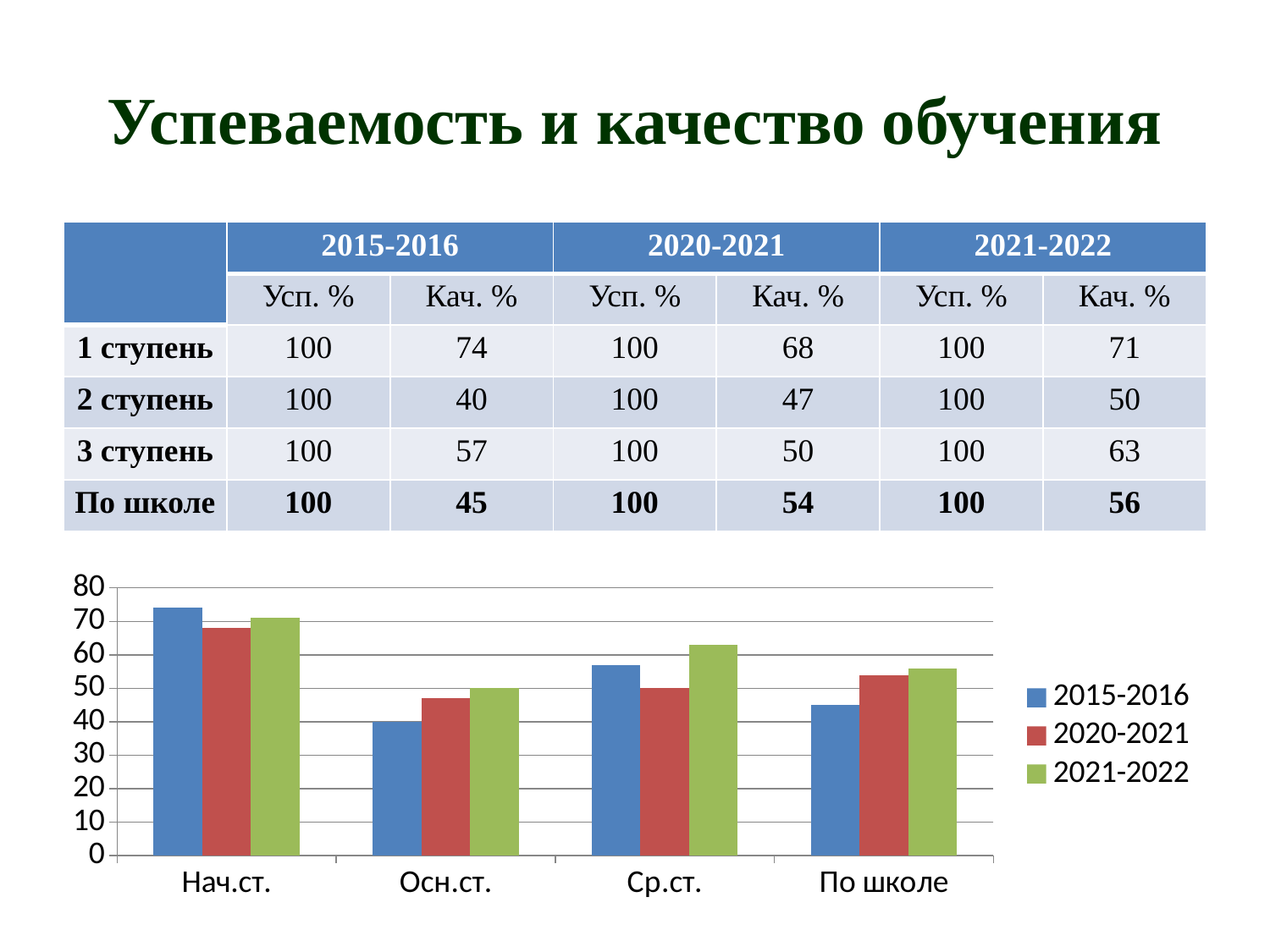
Is the 2015-2016 value for По школе greater or less than 50? less How many series does the chart legend list? 3 What is the difference between the 2020-2021 bar for Ср.ст. and the 2015-2016 bar for Осн.ст.? 10 What type of chart is shown on the slide? bar chart Is the 2015-2016 value for Нач.ст. greater or less than 70? greater What is the value of the 2015-2016 bar for Осн.ст.? 40 Which category has the lowest 2015-2016 bar? Осн.ст. How many categories are shown on the x axis of the chart? 4 What is the value of the 2020-2021 bar for Ср.ст.? 50 What is the value of the 2021-2022 bar for Осн.ст.? 50 For Ср.ст., which is larger: the 2020-2021 bar or the 2021-2022 bar? 2021-2022 Which category has the highest 2015-2016 bar? Нач.ст.